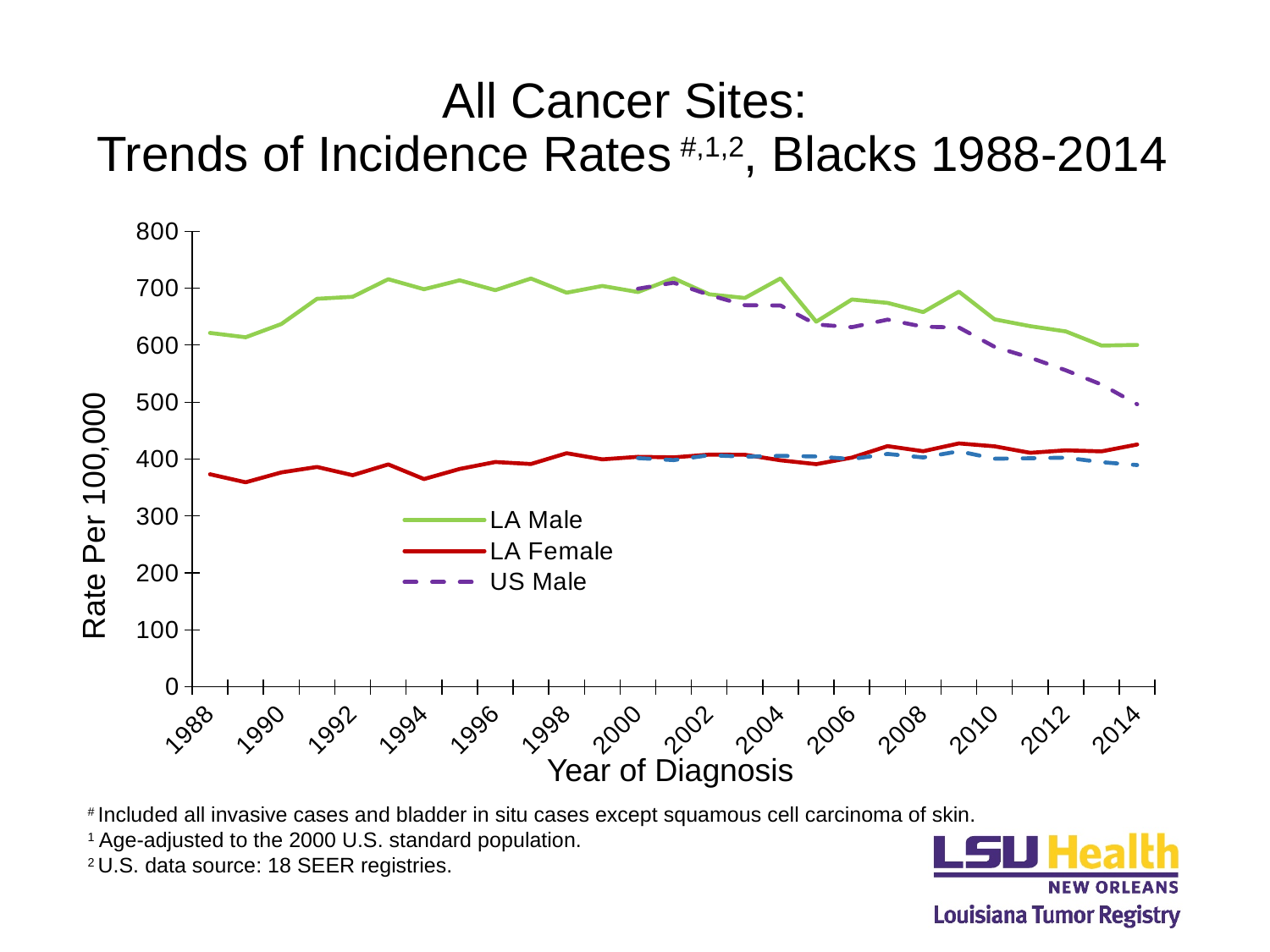
Is the value for LA Female in 1988 greater or less than 400? less Which series are listed in the legend? LA Male, LA Female, US Male How many series does the legend list? 3 What is the label of the y axis? Rate Per 100,000 Is the value for LA Male in 1988 greater or less than 600? greater What kind of chart is shown on the slide? Line chart Which series has the lowest values across the chart? LA Female Is the value for LA Female in 2014 greater or less than 400? greater Which series has the higher value in 2014, LA Male or US Male? LA Male Which series has the higher value in 2000, LA Male or LA Female? LA Male Does the US Male series rise or fall from 2000 to 2014? Fall